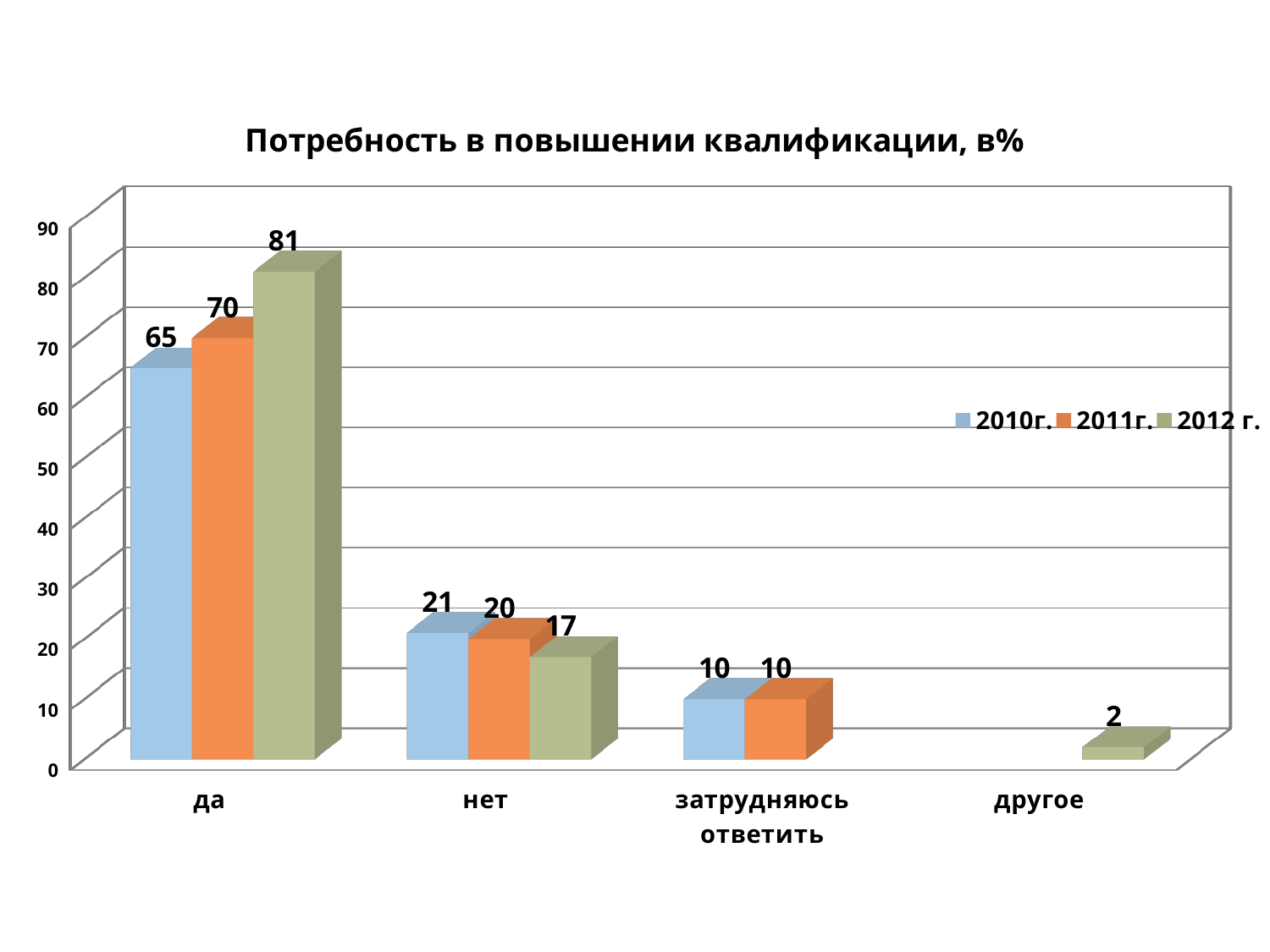
What is the value for "другое" in the 2012 г. series? 2 Which colour represents the 2011г. series in the legend? orange What is the difference between the 2012 г. and 2010г. values for "да"? 16 What is the value for "да" in the 2012 г. series? 81 What is the title of the chart? Потребность в повышении квалификации, в% Which category has the highest value in the 2011г. series? да What kind of chart is shown on the slide? bar chart Which is larger for "нет": the 2010г. value or the 2012 г. value? 2010г. Which category has the lowest value in the 2012 г. series? другое How many categories are shown on the x axis? 4 How many series does the legend list? 3 What is the value for "нет" in the 2010г. series? 21